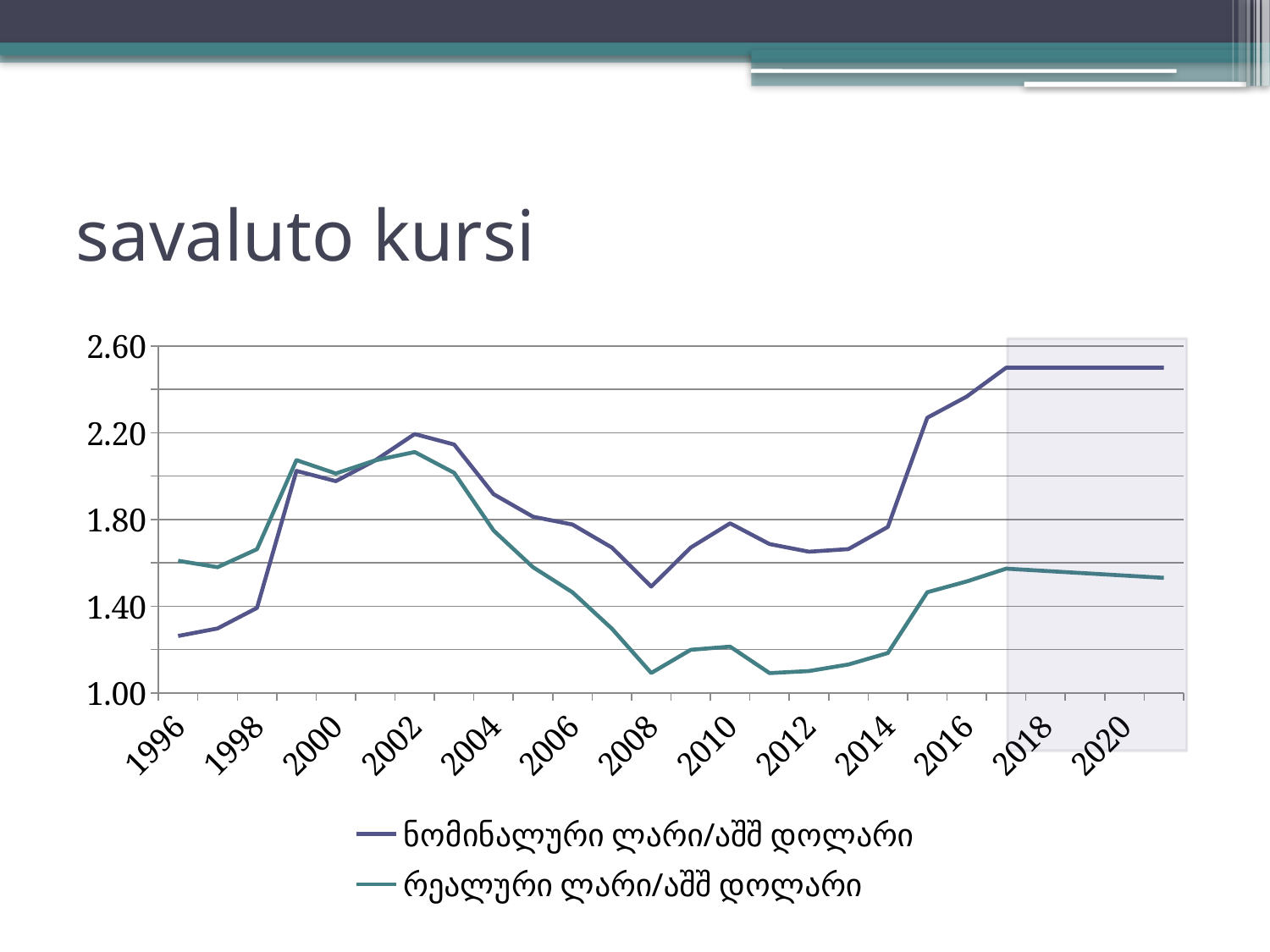
Is the value for ნომინალური ლარი/აშშ დოლარი in 2018 greater or less than 2.20? greater In 1996, which series has the higher value, ნომინალური ლარი/აშშ დოლარი or რეალური ლარი/აშშ დოლარი? რეალური ლარი/აშშ დოლარი Is the value for ნომინალური ლარი/აშშ დოლარი in 1996 greater or less than 1.40? less In 2012, which series has the higher value, ნომინალური ლარი/აშშ დოლარი or რეალური ლარი/აშშ დოლარი? ნომინალური ლარი/აშშ დოლარი Which series is drawn in the dark purple line? ნომინალური ლარი/აშშ დოლარი Does the რეალური ლარი/აშშ დოლარი line rise or fall between 2002 and 2008? fall What kind of chart is shown on the slide? line chart What is the title of the slide containing the chart? savaluto kursi Does the ნომინალური ლარი/აშშ დოლარი line rise or fall between 2014 and 2018? rise Is the value for რეალური ლარი/აშშ დოლარი in 2016 greater or less than 1.40? greater How many series does the legend list? 2